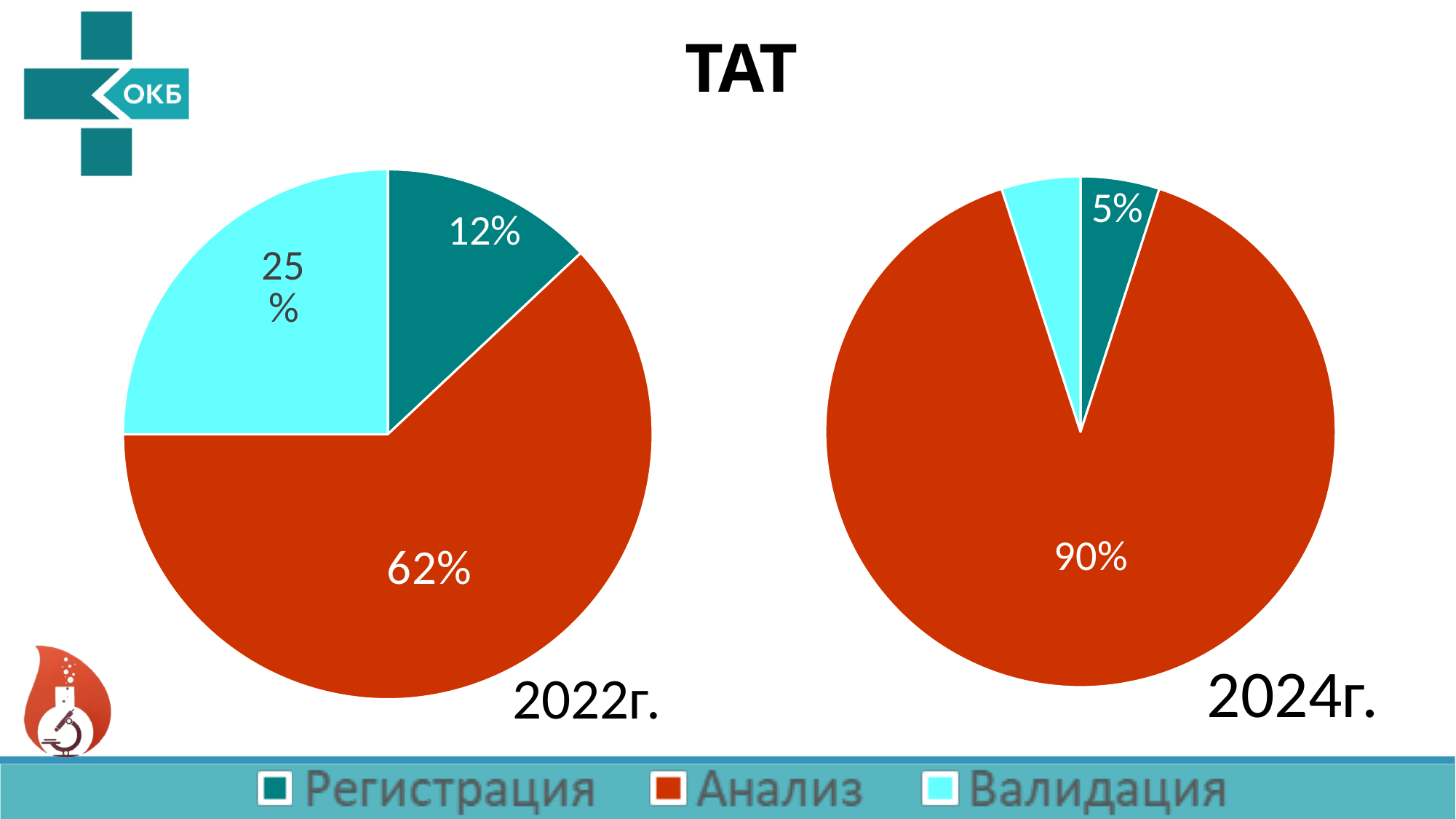
In the 2022г. pie chart, which is larger, Валидация or Регистрация? Валидация In the 2024г. pie chart, which category has the largest slice? Анализ In the 2022г. pie chart, what share does Анализ have? 62% How many series does the legend list? 3 In the 2024г. pie chart, what share does Анализ have? 90% What is the difference between the Анализ share in the 2024г. chart and the Анализ share in the 2022г. chart? 28% In the 2022г. pie chart, what share does Валидация have? 25% In the 2024г. pie chart, what share does Регистрация have? 5% In the 2022г. pie chart, which category has the largest slice? Анализ In the 2022г. pie chart, what share does Регистрация have? 12% In the 2022г. pie chart, which category has the smallest slice? Регистрация What type of chart is used for the 2022г. and 2024г. data? Pie chart